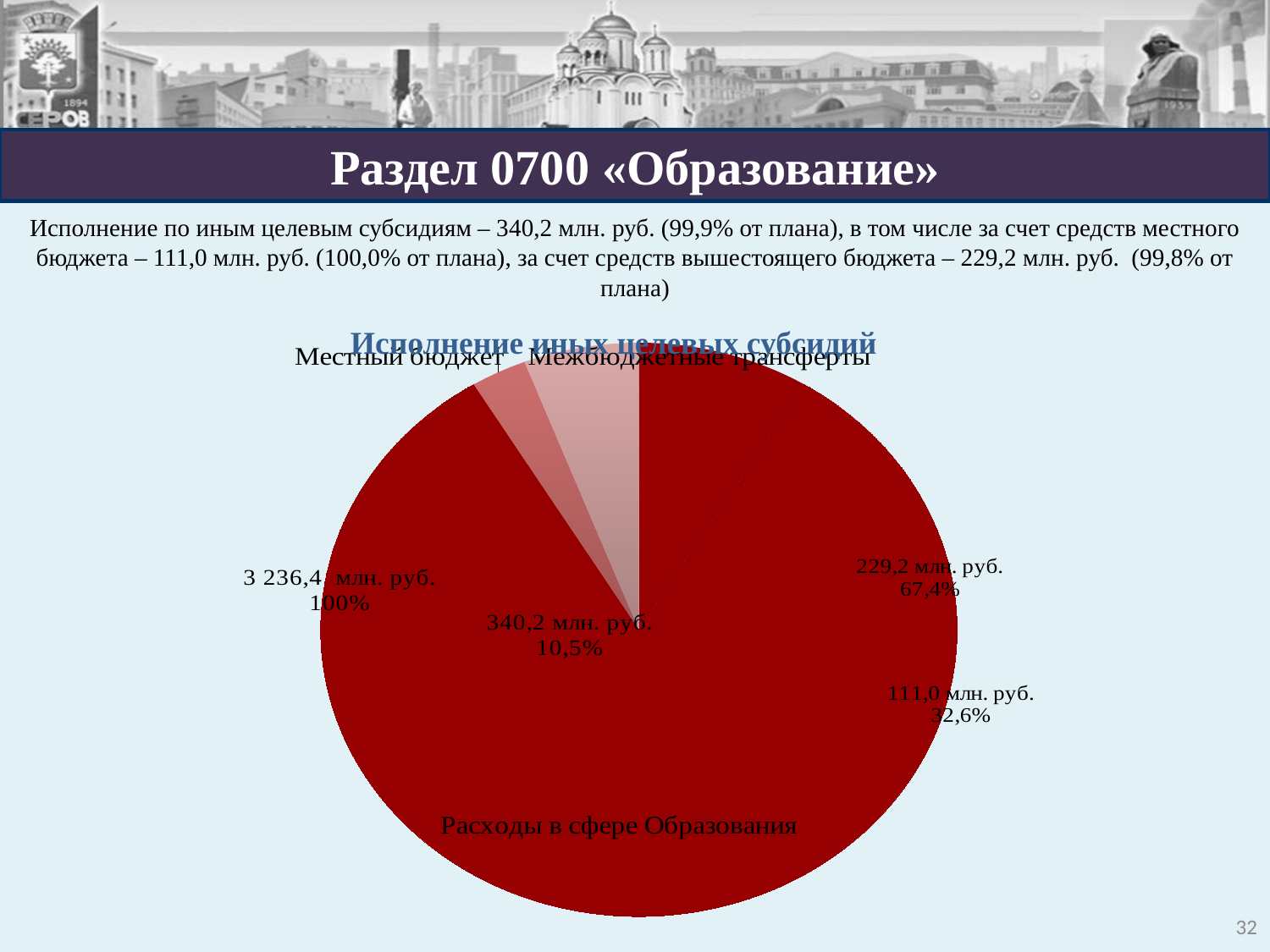
What value is labelled for Межбюджетные трансферты in the pie chart? 229,2 млн. руб. What percentage is shown next to the 229,2 млн. руб. label? 67,4% What is the difference between the Межбюджетные трансферты value (229,2 млн. руб.) and the Местный бюджет value (111,0 млн. руб.)? 118,2 млн. руб. What kind of chart is shown on the slide? pie chart What value is labelled for Расходы в сфере Образования? 3 236,4 млн. руб. What colour is the largest slice, Расходы в сфере Образования? dark red What is the title of the chart? Исполнение иных целевых субсидий What value is labelled for Местный бюджет in the pie chart? 111,0 млн. руб. What percentage is shown next to the 111,0 млн. руб. label? 32,6% Which is larger, Межбюджетные трансферты or Местный бюджет? Межбюджетные трансферты How many category labels are shown on the pie chart? 3 What percentage is shown next to the 340,2 млн. руб. label? 10,5%